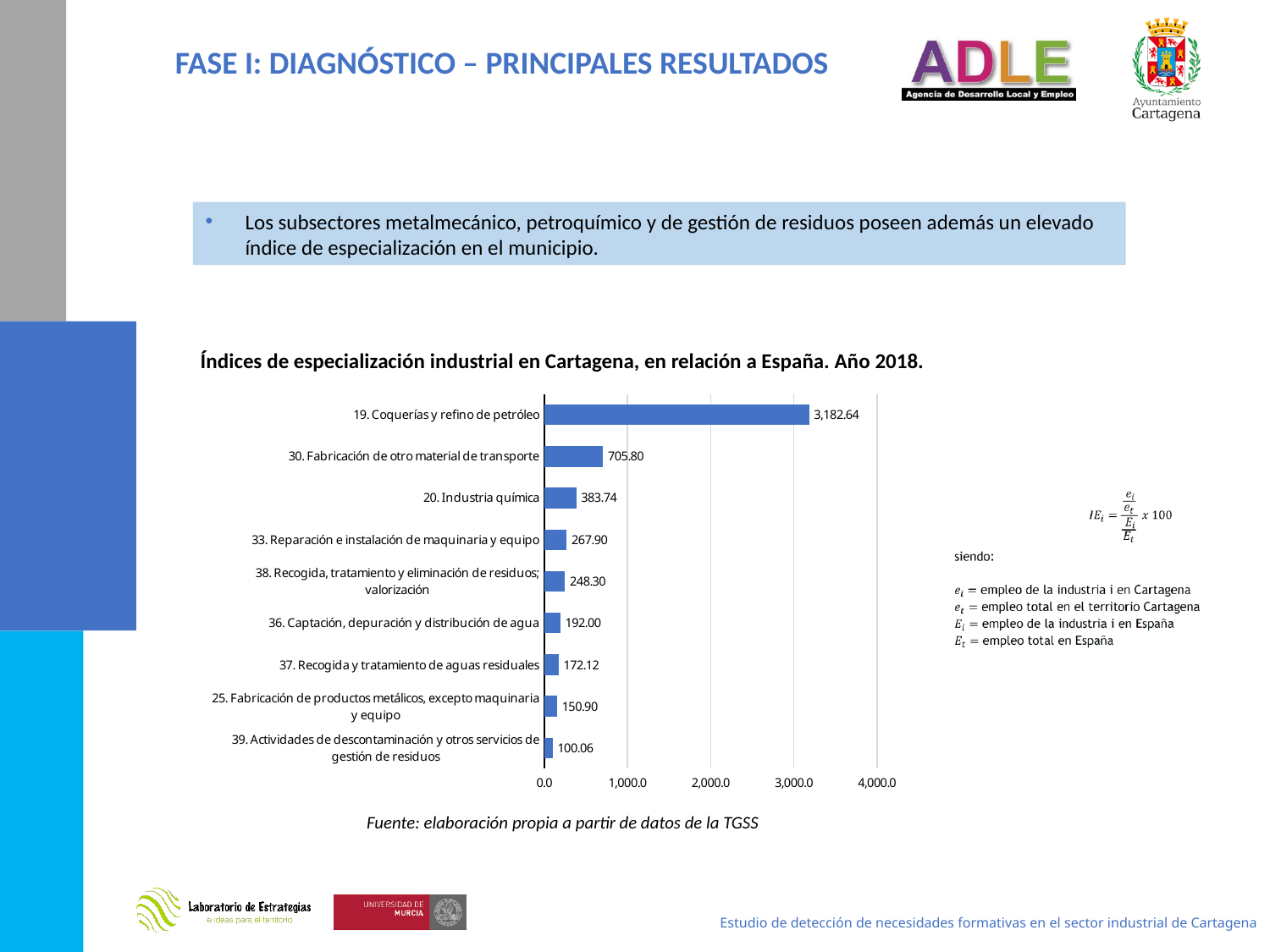
Which category has the highest value? 19. Coquerías y refino de petróleo What kind of chart is shown on the slide? bar chart What is the value for '20. Industria química'? 383.74 What is the value for '25. Fabricación de productos metálicos, excepto maquinaria y equipo'? 150.90 Which category has the lowest value? 39. Actividades de descontaminación y otros servicios de gestión de residuos Is the value for '30. Fabricación de otro material de transporte' greater or less than 1,000.0? less Which is larger: the value for '33. Reparación e instalación de maquinaria y equipo' or '38. Recogida, tratamiento y eliminación de residuos; valorización'? 33. Reparación e instalación de maquinaria y equipo What is the title of the chart? Índices de especialización industrial en Cartagena, en relación a España. Año 2018. How many categories are shown in the chart? 9 What is the value for '19. Coquerías y refino de petróleo'? 3,182.64 What is the difference between the values for '30. Fabricación de otro material de transporte' and '20. Industria química'? 322.06 What is the value for '36. Captación, depuración y distribución de agua'? 192.00